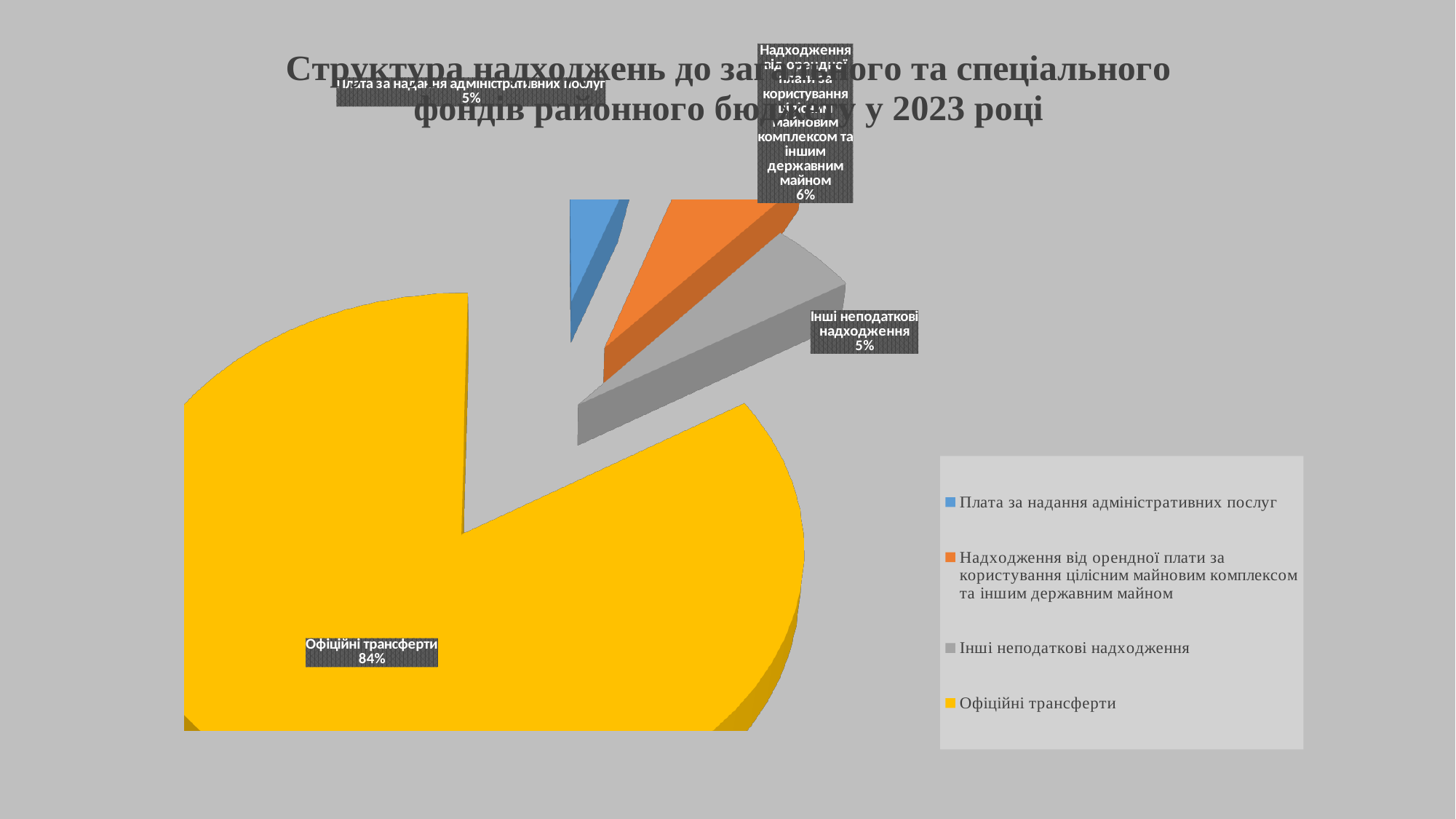
How many slices does the pie chart have? 4 What share of the pie does "Надходження від орендної плати за користування цілісним майновим комплексом та іншим державним майном" hold? 6% Which category has the largest slice of the pie? Офіційні трансферти Which year does the chart title refer to? 2023 What share of the pie does "Плата за надання адміністративних послуг" hold? 5% What type of chart is shown on the slide? pie chart What share of the pie does "Офіційні трансферти" hold? 84% How many entries does the legend list? 4 What is the difference in percentage points between "Офіційні трансферти" and "Надходження від орендної плати за користування цілісним майновим комплексом та іншим державним майном"? 78 Which is larger: the share for "Надходження від орендної плати за користування цілісним майновим комплексом та іншим державним майном" or the share for "Інші неподаткові надходження"? Надходження від орендної плати за користування цілісним майновим комплексом та іншим державним майном What colour is the slice for "Офіційні трансферти"? yellow